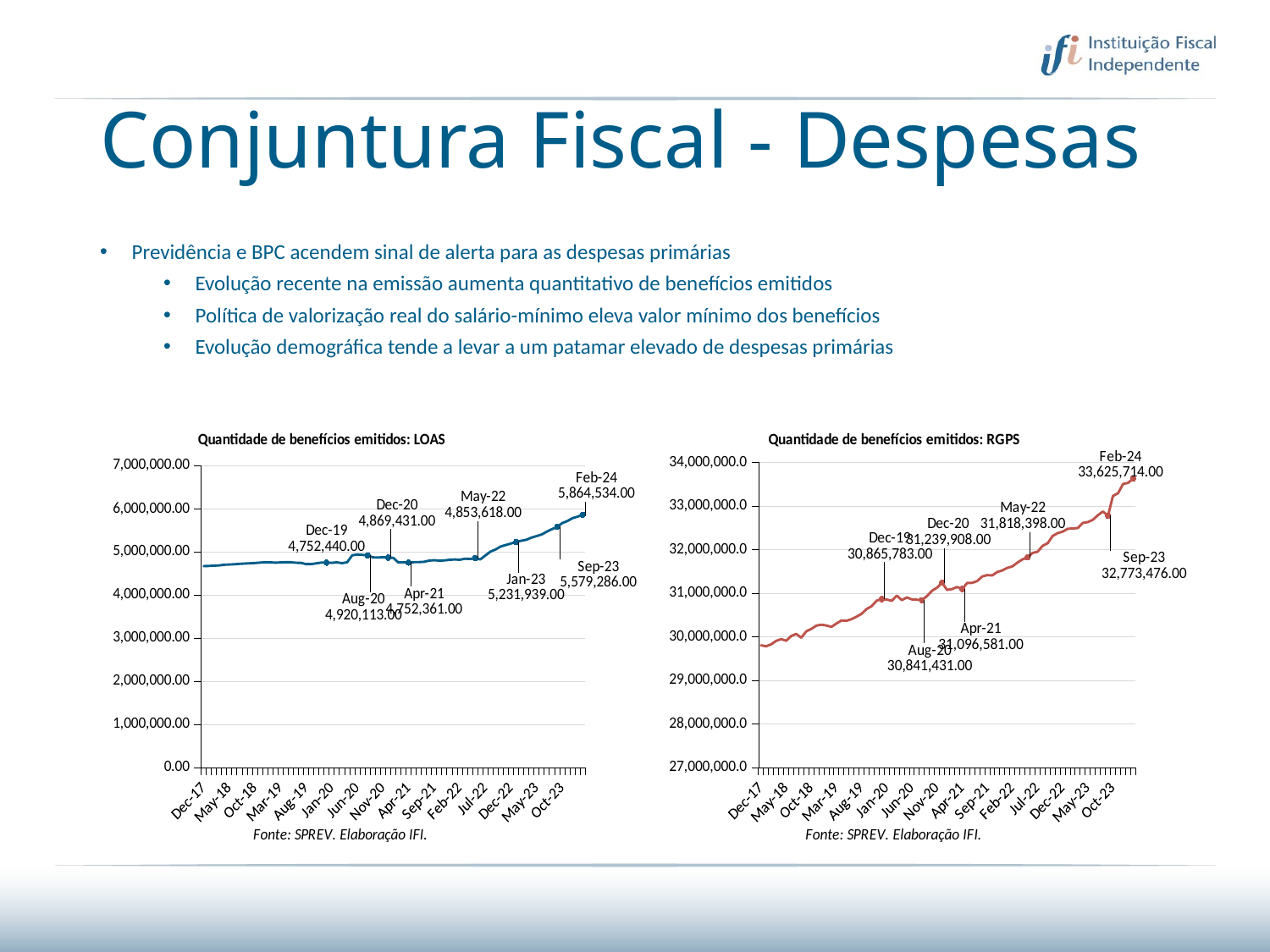
In the chart 'Quantidade de benefícios emitidos: LOAS', is the value for Dec-17 greater or less than 5,000,000.00? less In the chart 'Quantidade de benefícios emitidos: LOAS', what is the value labeled for Aug-20? 4,920,113.00 In the chart 'Quantidade de benefícios emitidos: RGPS', what is the difference between the labeled values for Dec-20 and Dec-19? 374,125.00 In the chart 'Quantidade de benefícios emitidos: RGPS', what is the value labeled for Aug-20? 30,841,431.00 In the chart 'Quantidade de benefícios emitidos: LOAS', what is the value labeled for Jan-23? 5,231,939.00 In the chart 'Quantidade de benefícios emitidos: RGPS', what is the value labeled for May-22? 31,818,398.00 In the chart 'Quantidade de benefícios emitidos: RGPS', do the values generally rise or fall from Dec-17 to Feb-24? Rise In the chart 'Quantidade de benefícios emitidos: LOAS', what is the value labeled for Feb-24? 5,864,534.00 In the chart 'Quantidade de benefícios emitidos: RGPS', what is the value labeled for Feb-24? 33,625,714.00 In the chart 'Quantidade de benefícios emitidos: LOAS', what is the difference between the labeled values for Feb-24 and Sep-23? 285,248.00 In the chart 'Quantidade de benefícios emitidos: LOAS', which labeled value is larger, Dec-20 or Apr-21? Dec-20 What type of chart is 'Quantidade de benefícios emitidos: LOAS'? Line chart